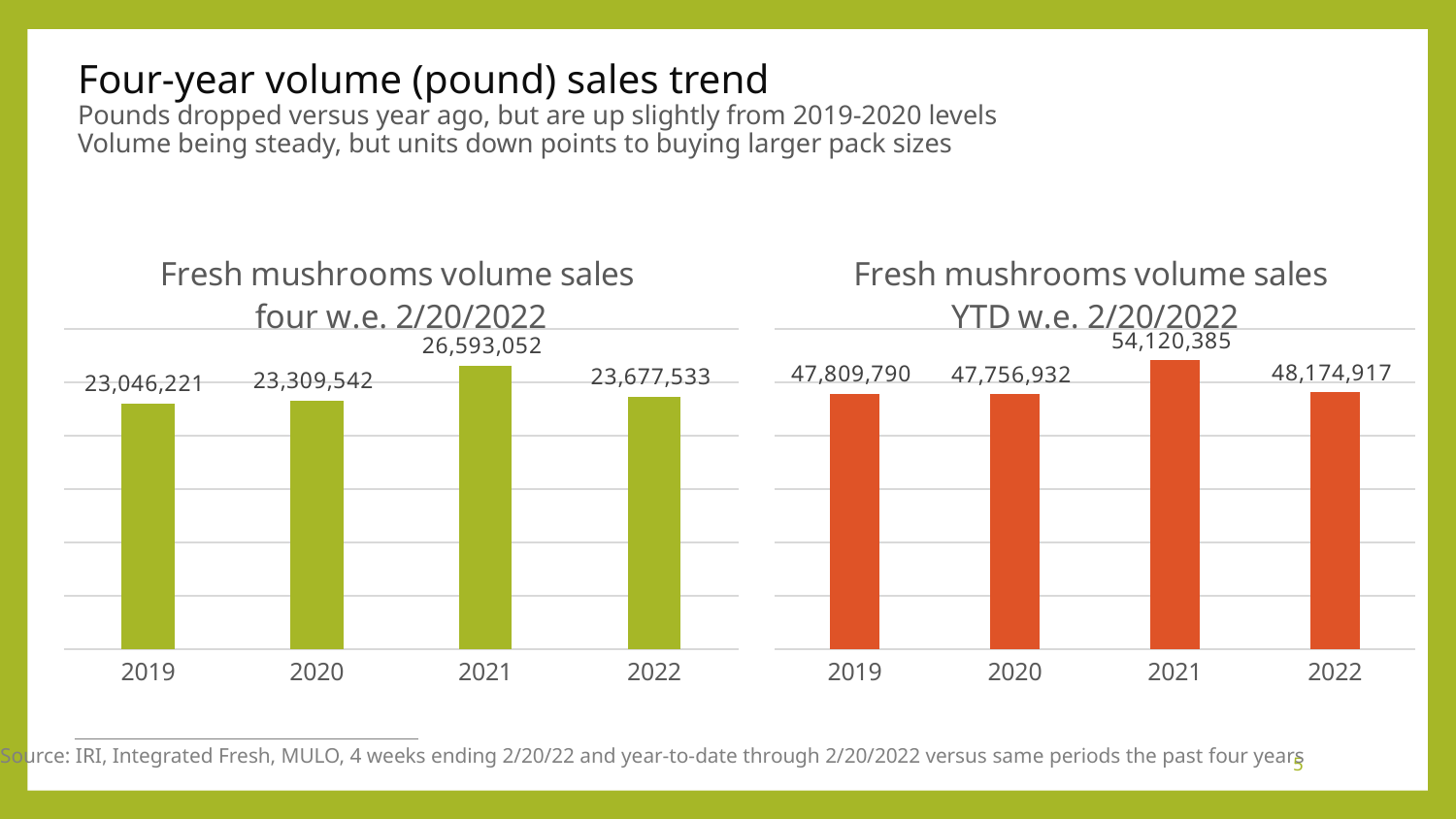
In the 'Fresh mushrooms volume sales four w.e. 2/20/2022' chart, what is the value for 2021? 26,593,052 In the 'Fresh mushrooms volume sales YTD w.e. 2/20/2022' chart, which year has the highest value? 2021 What type of chart is the 'Fresh mushrooms volume sales four w.e. 2/20/2022' chart? Bar chart In the 'Fresh mushrooms volume sales YTD w.e. 2/20/2022' chart, what is the value for 2020? 47,756,932 In the 'Fresh mushrooms volume sales YTD w.e. 2/20/2022' chart, what is the value for 2022? 48,174,917 In the 'Fresh mushrooms volume sales four w.e. 2/20/2022' chart, what is the difference between the 2021 and 2022 values? 2,915,519 In the 'Fresh mushrooms volume sales four w.e. 2/20/2022' chart, which year has the highest value? 2021 What colour are the bars in the 'Fresh mushrooms volume sales YTD w.e. 2/20/2022' chart? Orange How many years are shown in the 'Fresh mushrooms volume sales YTD w.e. 2/20/2022' chart? 4 In the 'Fresh mushrooms volume sales YTD w.e. 2/20/2022' chart, what is the difference between the 2021 and 2022 values? 5,945,468 In the 'Fresh mushrooms volume sales four w.e. 2/20/2022' chart, what is the value for 2019? 23,046,221 In the 'Fresh mushrooms volume sales four w.e. 2/20/2022' chart, which is larger, the value for 2020 or the value for 2022? 2022